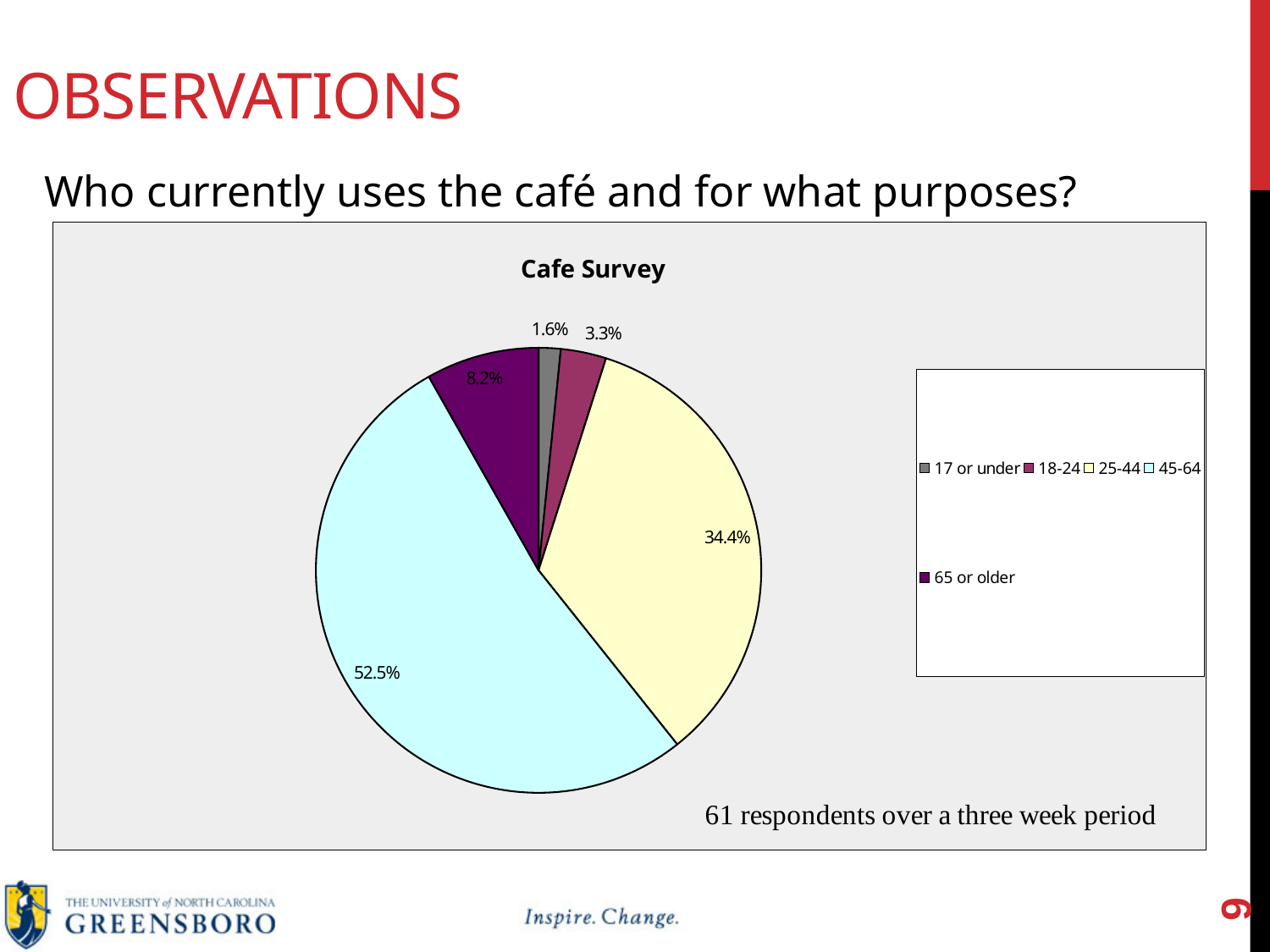
Which age group has the largest share of the pie? 45-64 What is the title of the chart? Cafe Survey How many age groups does the legend list? 5 Which age group has the smallest share of the pie? 17 or under What share of the pie does the 45-64 age group hold? 52.5% What share of the pie does the 17 or under age group hold? 1.6% What share of the pie does the 18-24 age group hold? 3.3% What share of the pie does the 65 or older age group hold? 8.2% What kind of chart is shown on the slide? pie chart Which has a larger share, the 65 or older group or the 18-24 group? 65 or older What is the difference between the shares of the 45-64 and 25-44 age groups? 18.1% What share of the pie does the 25-44 age group hold? 34.4%